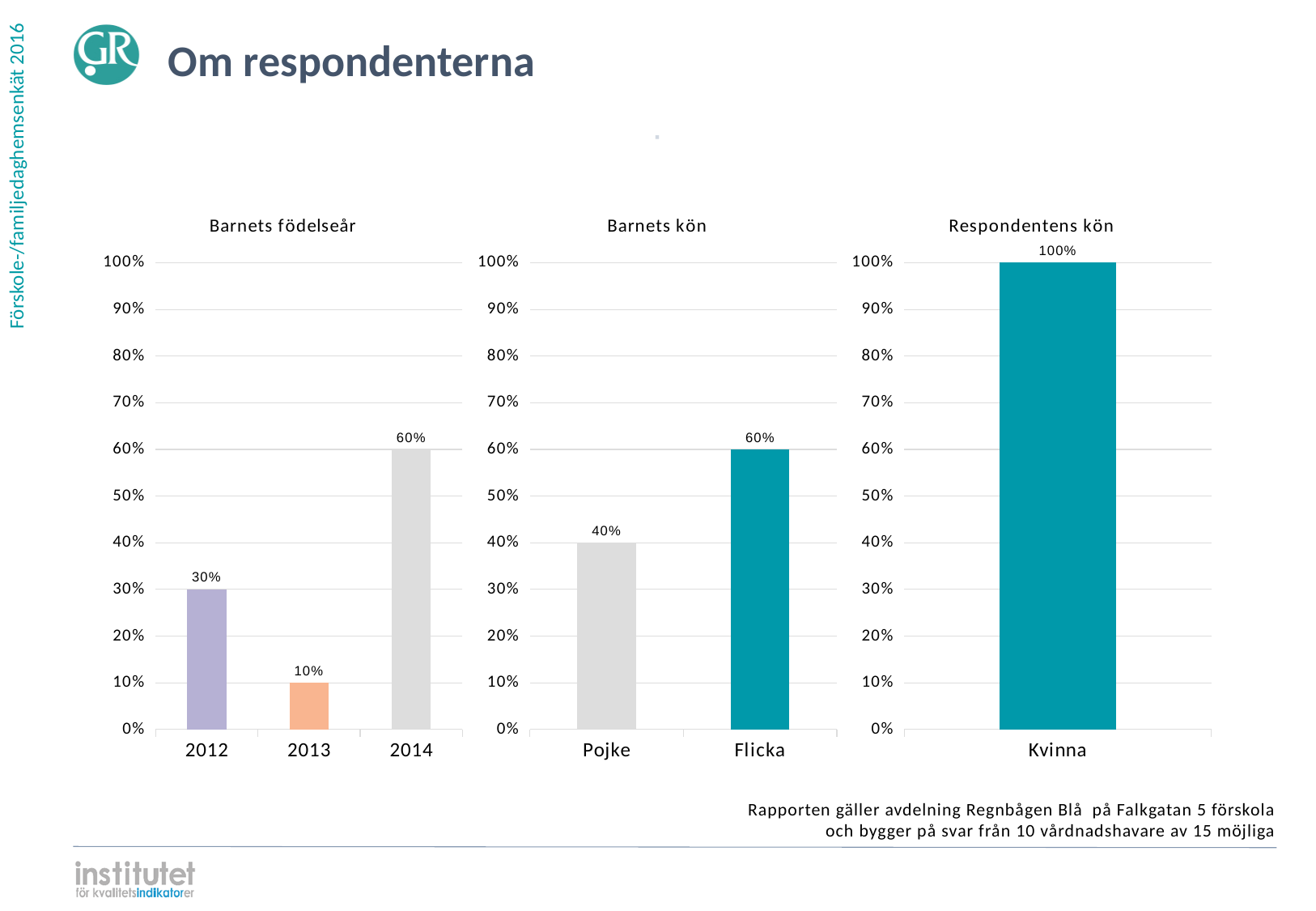
In the 'Barnets kön' chart, what is the difference between Flicka and Pojke? 20% In the 'Respondentens kön' chart, how many categories are shown on the x axis? 1 In the 'Barnets födelseår' chart, what is the value for 2014? 60% In the 'Barnets födelseår' chart, what is the value for 2013? 10% In the 'Barnets födelseår' chart, which year has the highest value? 2014 In the 'Barnets födelseår' chart, which year has the lowest value? 2013 In the 'Barnets födelseår' chart, what is the difference between the values for 2014 and 2012? 30% What kind of chart is the 'Barnets kön' chart? Bar chart In the 'Barnets kön' chart, what is the value for Pojke? 40% In the 'Respondentens kön' chart, what is the value for Kvinna? 100% In the 'Barnets födelseår' chart, how many categories are shown on the x axis? 3 In the 'Barnets kön' chart, which is larger, Pojke or Flicka? Flicka